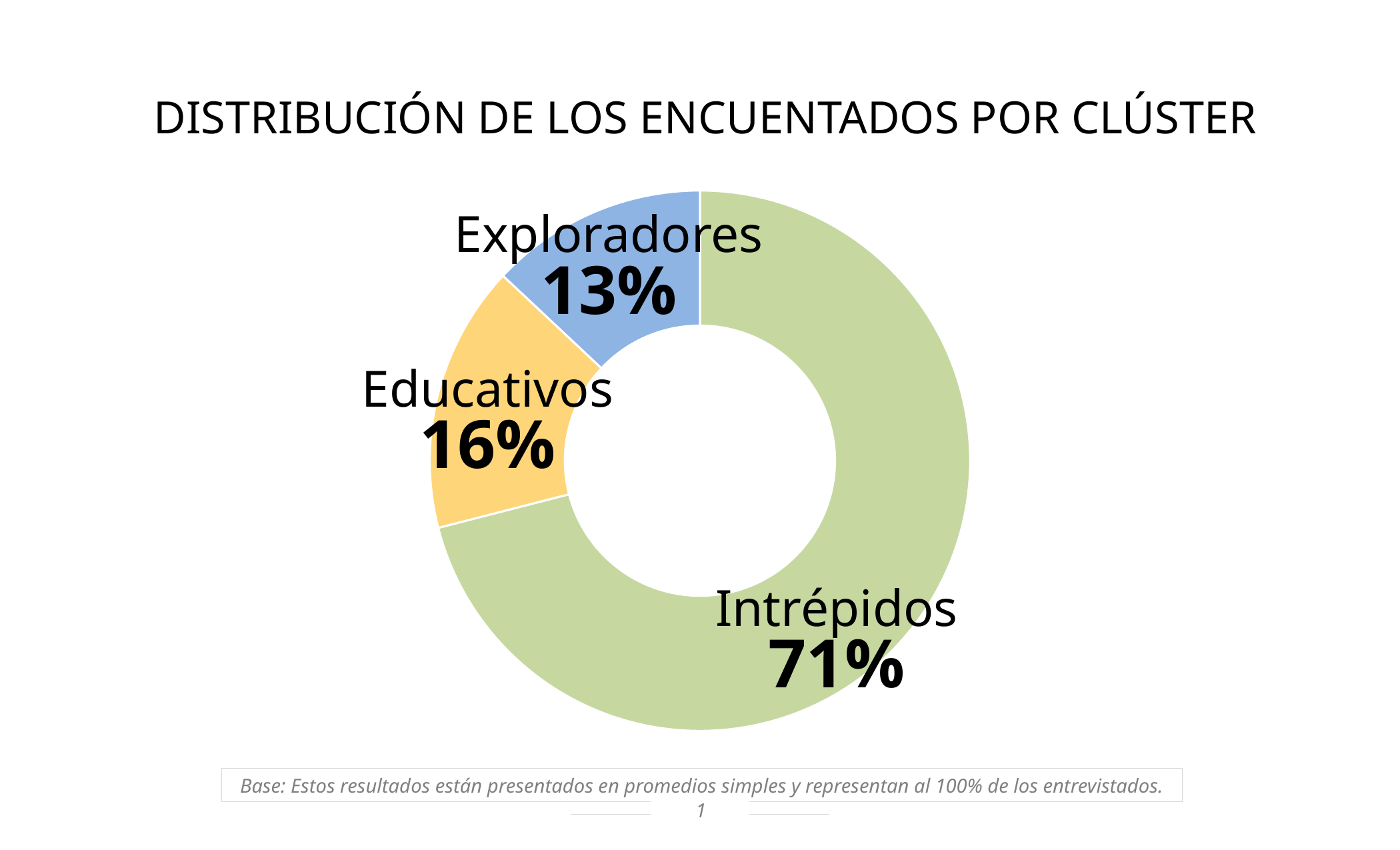
What is the difference in percentage points between the Intrépidos and Educativos clusters? 55 What kind of chart is shown on the slide? Doughnut (pie) chart What percentage of respondents are in the Exploradores cluster? 13% What percentage of respondents are in the Intrépidos cluster? 71% What is the difference in percentage points between the Educativos and Exploradores clusters? 3 Which cluster has the largest share of respondents? Intrépidos What percentage of respondents are in the Educativos cluster? 16% How many clusters are shown in the chart? 3 Which cluster has the smallest share of respondents? Exploradores What is the title of the chart? DISTRIBUCIÓN DE LOS ENCUENTADOS POR CLÚSTER Which cluster has a larger share, Educativos or Exploradores? Educativos What colour is the Intrépidos segment? Green